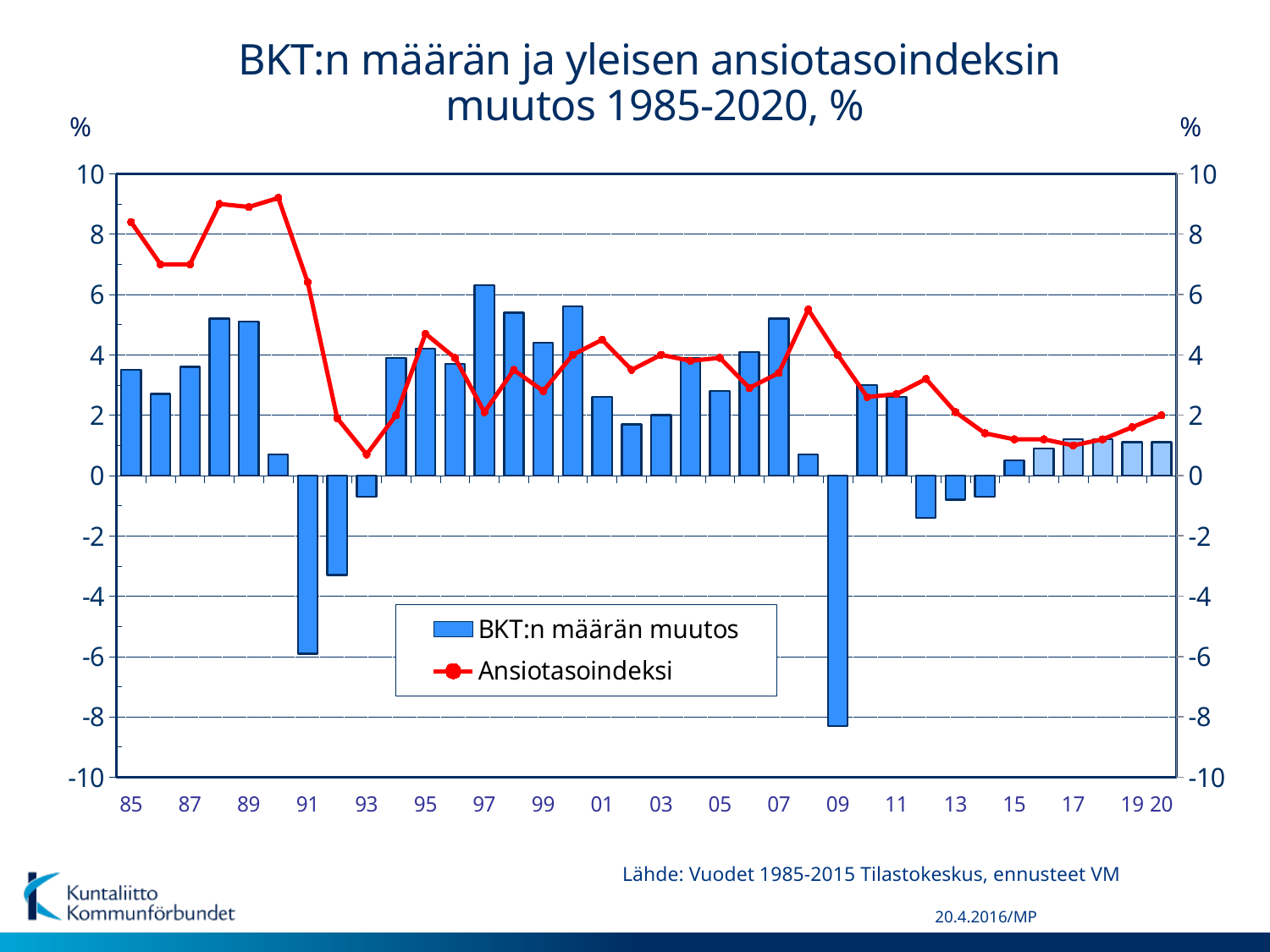
What kind of chart is shown on the slide? A combined bar and line chart Is the Ansiotasoindeksi value for 1993 greater or less than 2? less Is the BKT:n määrän muutos value for 1991 greater or less than -4? less Does the Ansiotasoindeksi line rise or fall overall from 1985 to 1993? Fall Which is larger, the BKT:n määrän muutos bar for 1988 or for 1991? 1988 Is the Ansiotasoindeksi value for 1985 greater or less than 8? greater Which series is drawn as a red line with markers? Ansiotasoindeksi How many series does the legend list? 2 In which year is the BKT:n määrän muutos bar the highest? 1997 What are the two series named in the legend? BKT:n määrän muutos and Ansiotasoindeksi In which year is the BKT:n määrän muutos bar the lowest? 2009